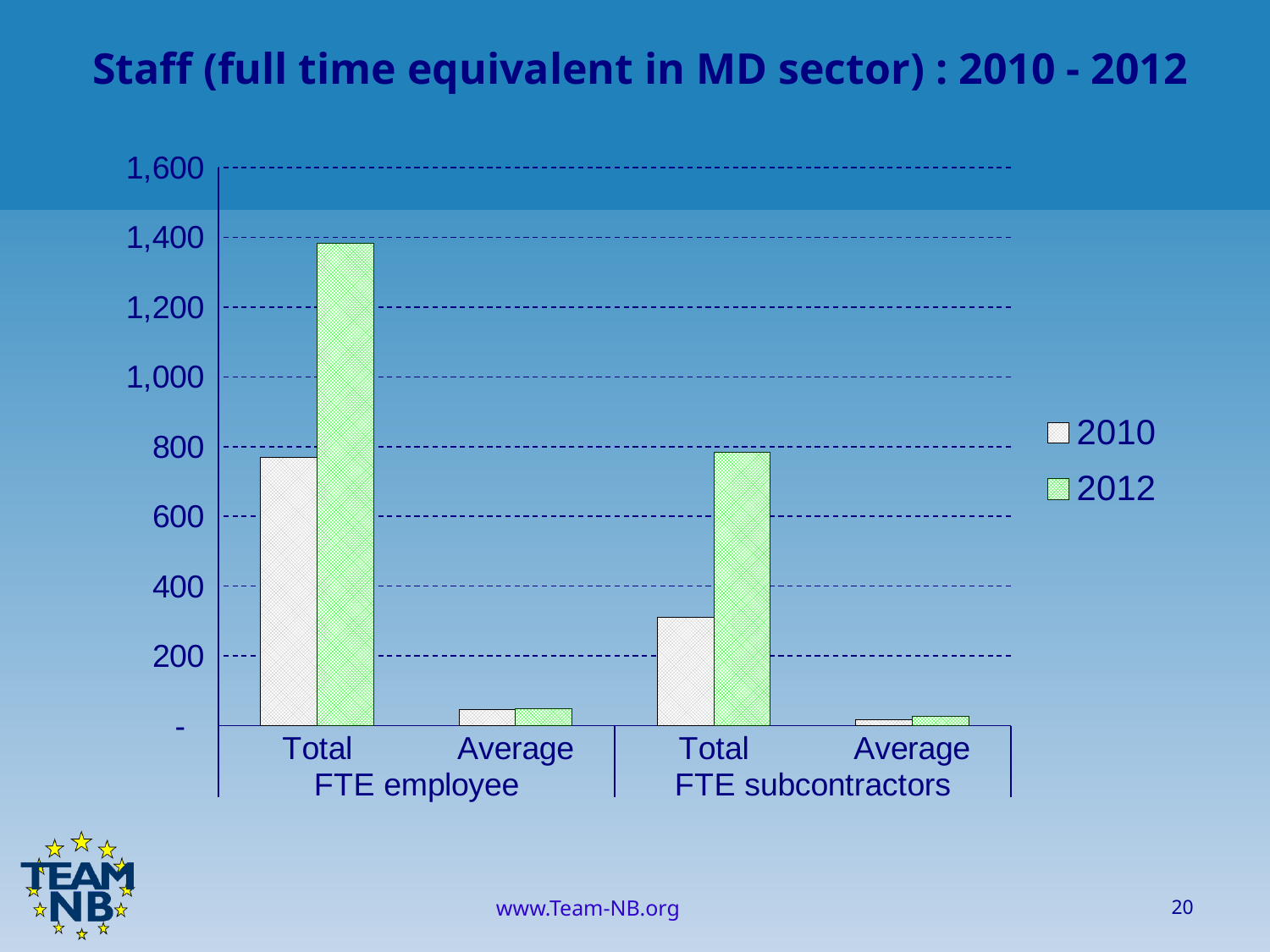
How many series does the legend list? 2 Is the 2012 value for Total FTE employee greater or less than 1,200? greater Is the 2010 value for Total FTE employee greater or less than 800? less Is the 2010 value for Total FTE subcontractors greater or less than 400? less Which category has the highest bar in the chart? Total FTE employee (2012) How many categories are shown along the x axis? 4 Which years are listed in the legend? 2010 and 2012 What is the title of the chart? Staff (full time equivalent in MD sector) : 2010 - 2012 For Total FTE subcontractors, which year has the larger value, 2010 or 2012? 2012 What kind of chart is shown on the slide? bar chart